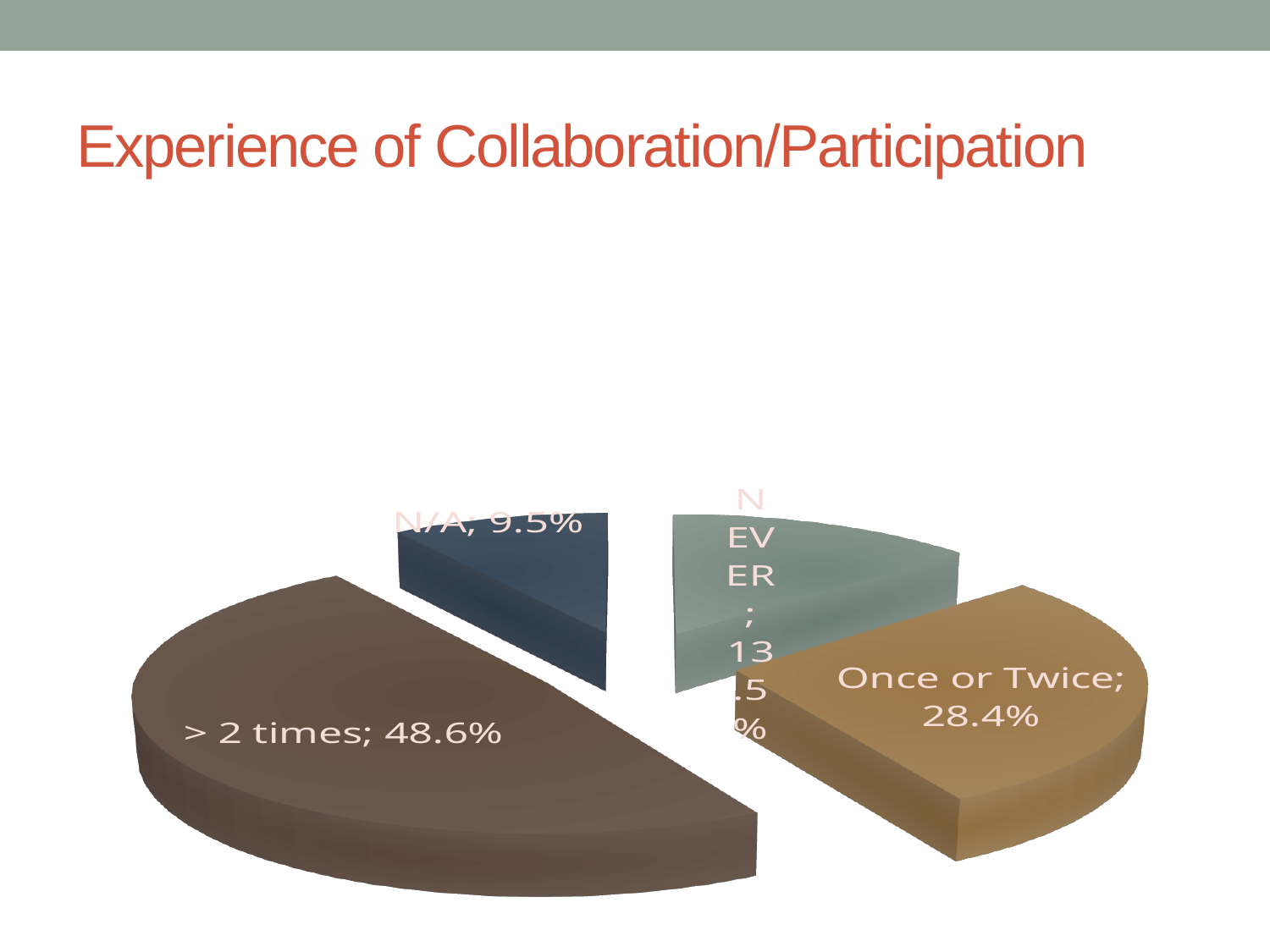
What percentage is shown for the "Once or Twice" slice? 28.4% Which category has the smallest share of the pie? N/A What percentage is shown for the "N/A" slice? 9.5% What kind of chart is shown on the slide? pie chart What percentage is shown for the "> 2 times" slice? 48.6% What is the combined percentage of the "Once or Twice" and "NEVER" slices? 41.9% What is the difference in percentage points between the "> 2 times" slice and the "Once or Twice" slice? 20.2 What is the title of the chart? Experience of Collaboration/Participation Which is larger, the "NEVER" slice or the "N/A" slice? NEVER How many slices does the pie chart have? 4 Which category has the largest share of the pie? > 2 times What percentage is shown for the "NEVER" slice? 13.5%